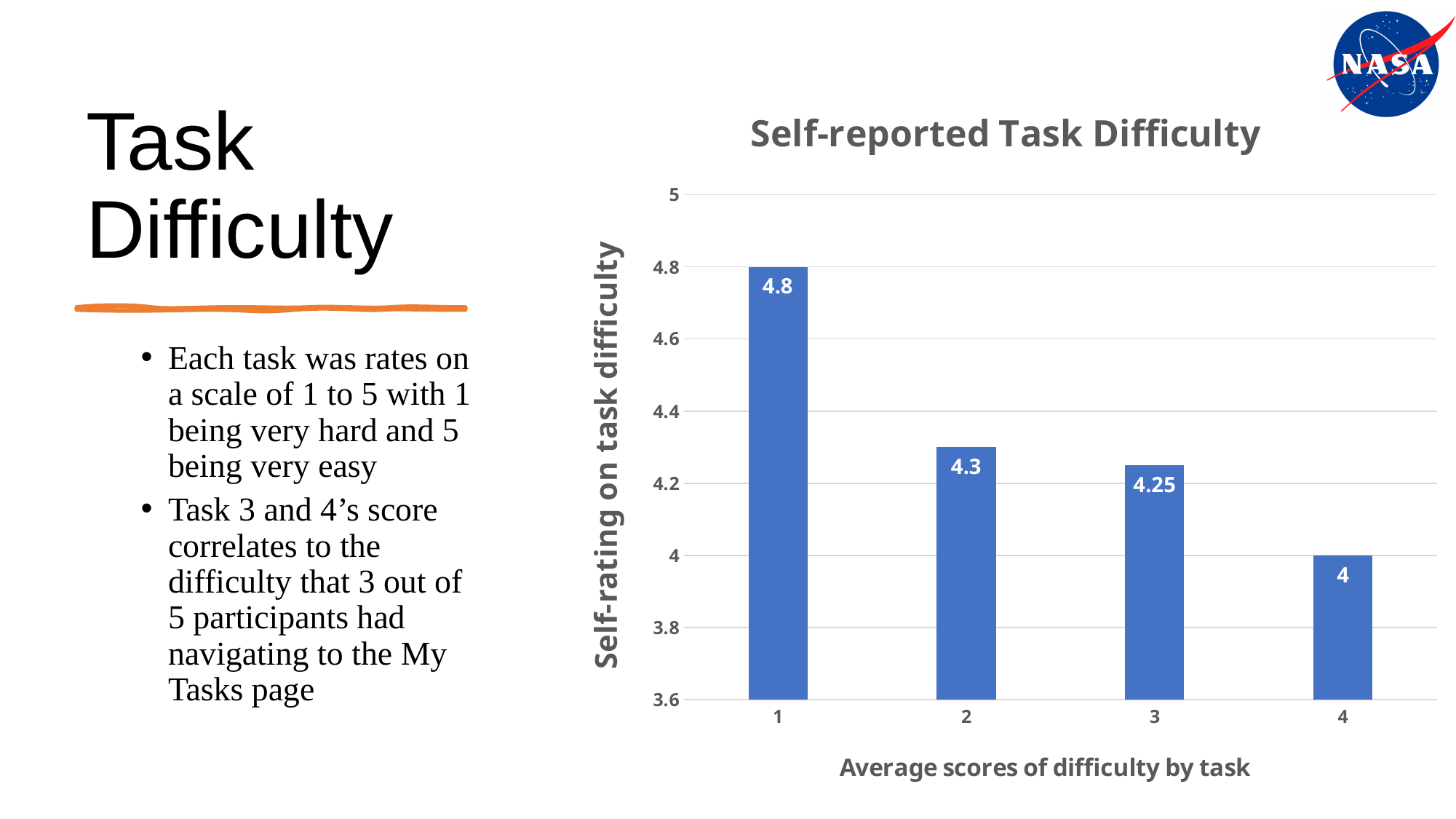
Which has a higher rating, task 2 or task 4? Task 2 Which task has the highest self-reported difficulty rating? 1 What is the difference between the ratings for task 2 and task 3? 0.05 Which task has the lowest self-reported difficulty rating? 4 What is the self-reported difficulty rating for task 4? 4 What is the self-reported difficulty rating for task 3? 4.25 How many tasks are shown in the chart? 4 Do the ratings rise or fall from task 1 to task 4? Fall What is the self-reported difficulty rating for task 1? 4.8 What kind of chart is shown on the slide? Bar chart Is the value for task 2 greater or less than 4.2? greater What is the difference between the ratings for task 1 and task 4? 0.8